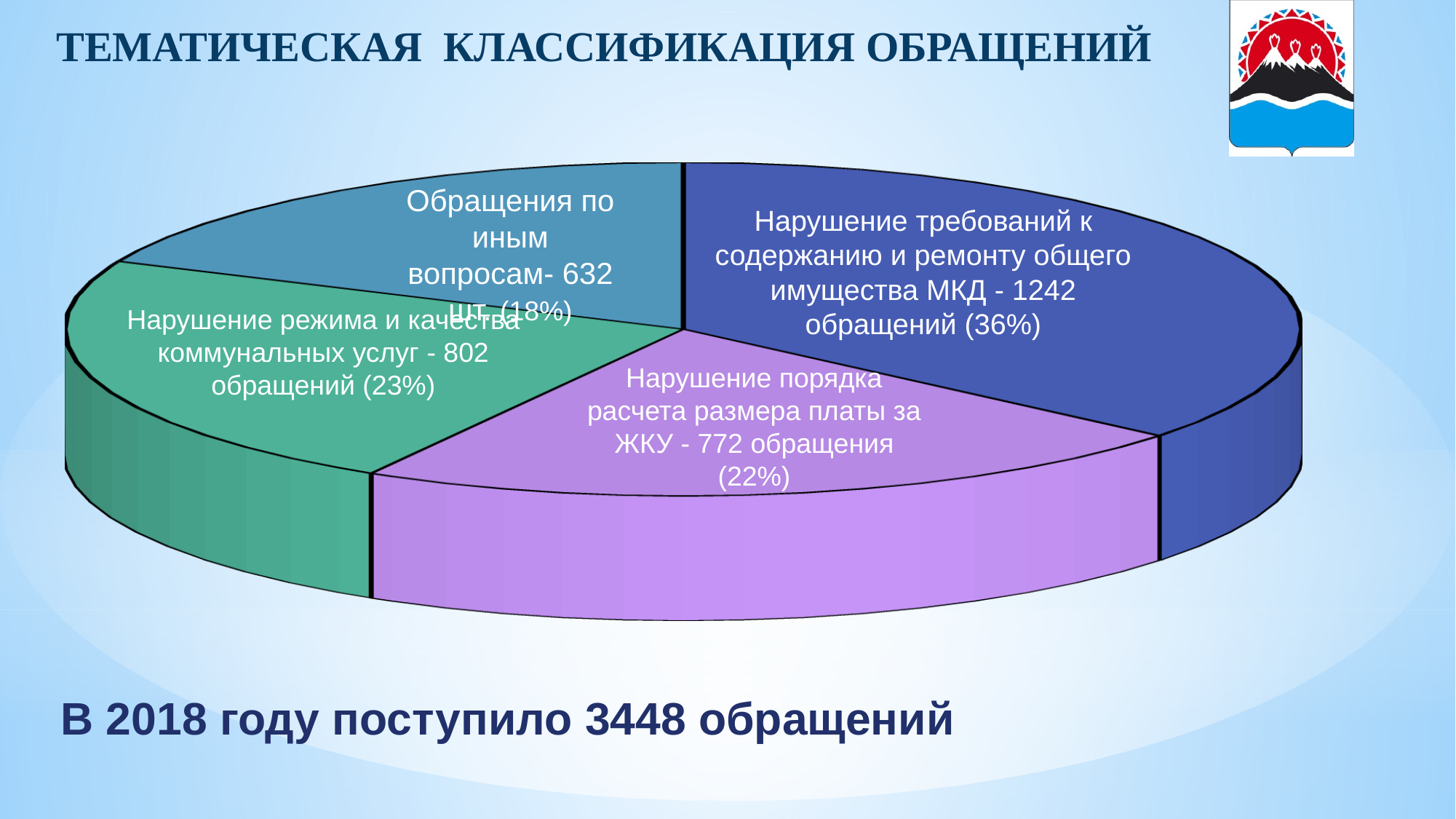
How many обращений are shown for "Нарушение режима и качества коммунальных услуг"? 802 What kind of chart is shown on the slide? Pie chart What percentage share does the slice "Обращения по иным вопросам" have? 18% How many обращений are shown for "Нарушение порядка расчета размера платы за ЖКУ"? 772 How many slices does the pie chart have? 4 What percentage share does the slice "Нарушение требований к содержанию и ремонту общего имущества МКД" have? 36% What is the title of the slide containing the pie chart? ТЕМАТИЧЕСКАЯ КЛАССИФИКАЦИЯ ОБРАЩЕНИЙ Which category has the largest number of обращений? Нарушение требований к содержанию и ремонту общего имущества МКД Which has more обращений: "Нарушение требований к содержанию и ремонту общего имущества МКД" or "Обращения по иным вопросам"? Нарушение требований к содержанию и ремонту общего имущества МКД Which category has the smallest number of обращений? Обращения по иным вопросам What is the difference in обращений between "Нарушение режима и качества коммунальных услуг" and "Нарушение порядка расчета размера платы за ЖКУ"? 30 How many обращений are shown for "Нарушение требований к содержанию и ремонту общего имущества МКД"? 1242